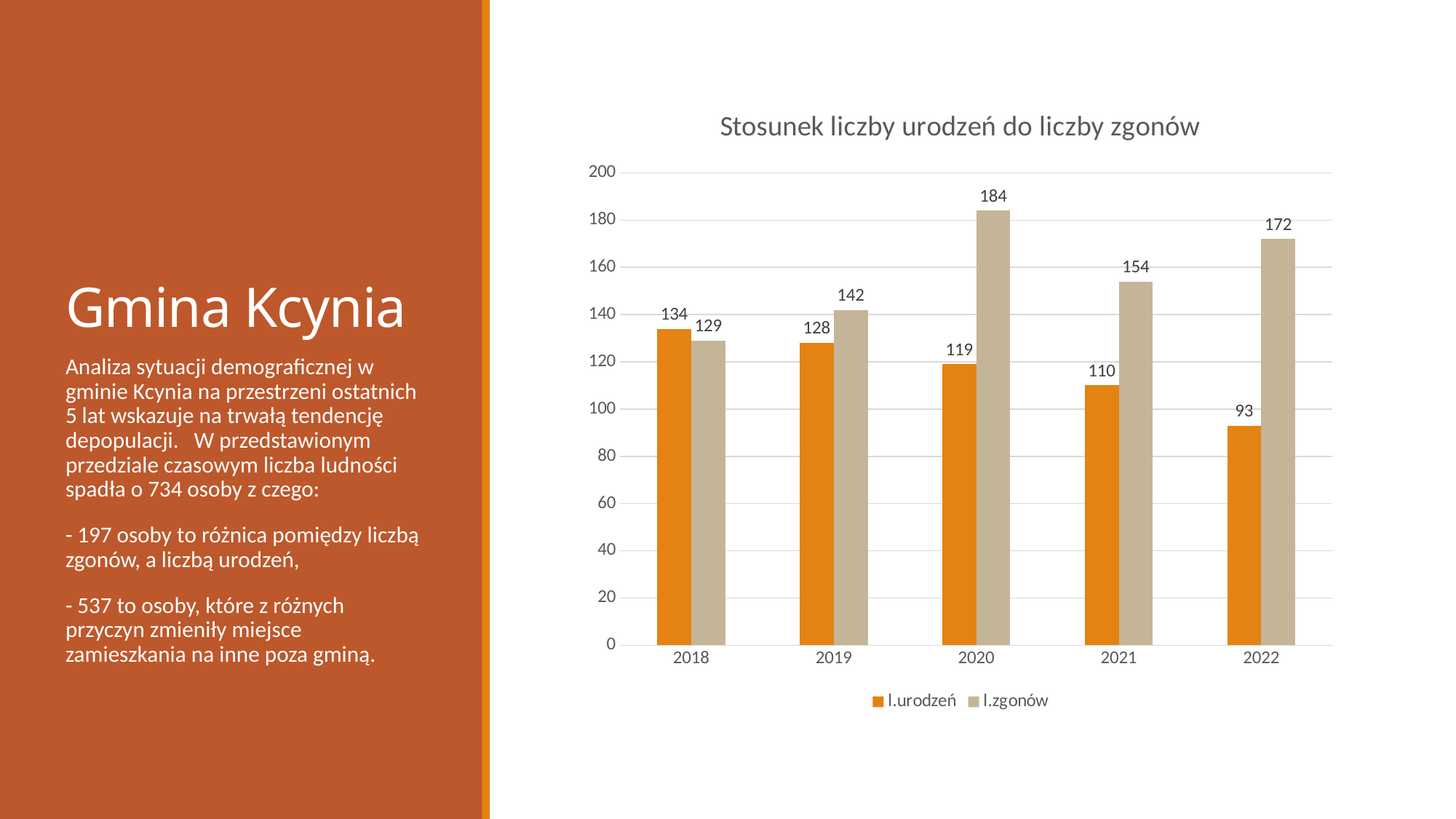
What is the value of l.zgonów for 2020? 184 Is the value of l.zgonów for 2022 greater or less than 160? greater What is the value of l.urodzeń for 2018? 134 What kind of chart is shown on the slide? bar chart Do the values for l.urodzeń rise or fall from 2018 to 2022? fall In 2018, which is larger: l.urodzeń or l.zgonów? l.urodzeń Which year has the highest value for l.zgonów? 2020 How many series does the legend list? 2 How many years are shown on the x axis? 5 What is the value of l.urodzeń for 2022? 93 What is the difference between l.zgonów and l.urodzeń in 2021? 44 Which year has the lowest value for l.urodzeń? 2022